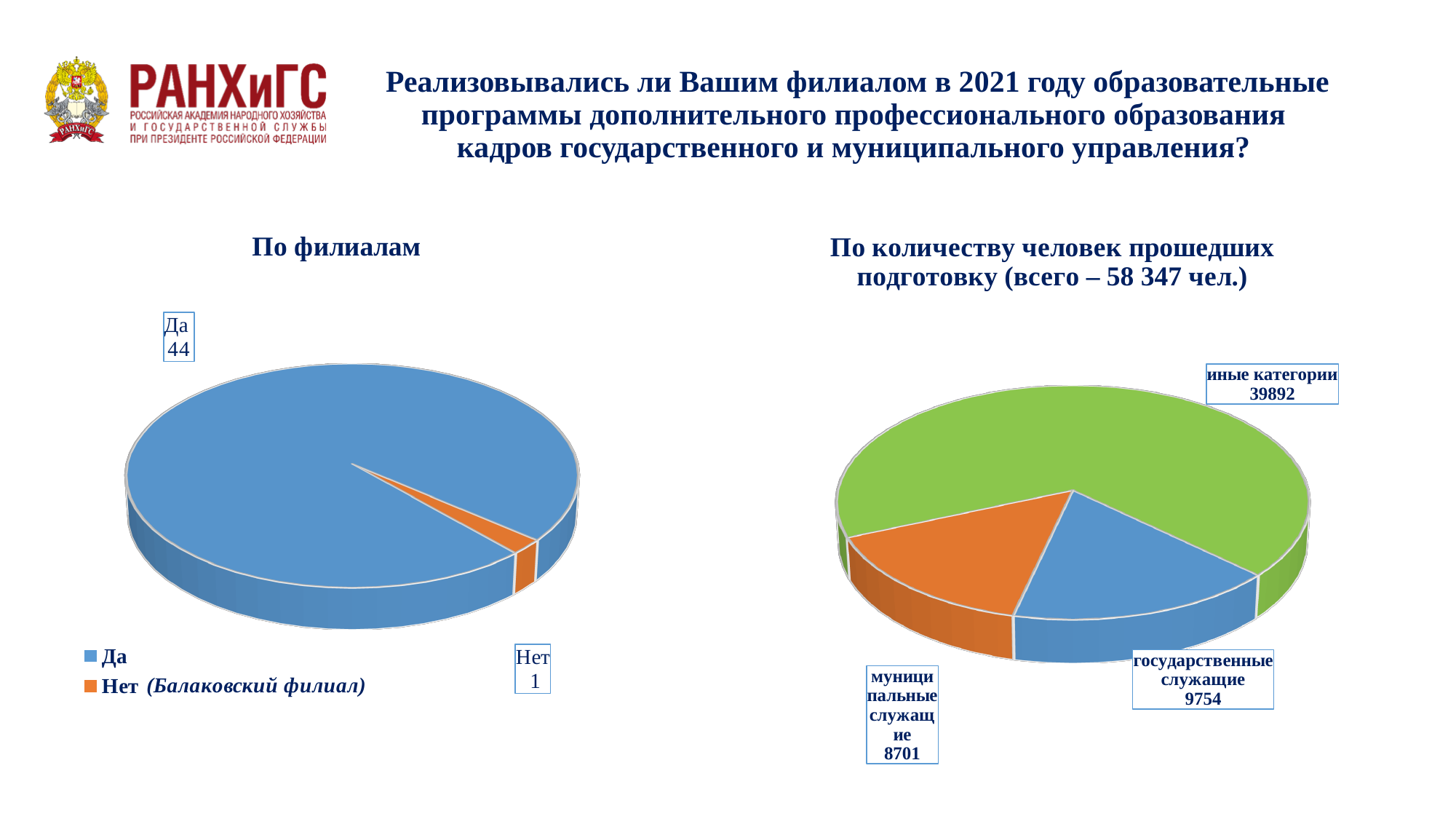
In the right chart on the number of people trained, which category has the largest value? иные категории In the chart titled 'По филиалам', which branch is named as having answered 'Нет'? Балаковский филиал In the right chart on the number of people trained, what is the value for 'муниципальные служащие'? 8701 In the chart titled 'По филиалам', what is the difference between the 'Да' and 'Нет' values? 43 What type of chart is the left chart titled 'По филиалам'? Pie chart In the right chart on the number of people trained, what is the value for 'государственные служащие'? 9754 How many categories does the right chart on the number of people trained show? 3 In the right chart on the number of people trained, what is the value for 'иные категории'? 39892 In the right chart on the number of people trained, what is the difference between 'государственные служащие' and 'муниципальные служащие'? 1053 In the right chart on the number of people trained, which category has the smallest value? муниципальные служащие In the chart titled 'По филиалам', how many branches answered 'Да'? 44 In the chart titled 'По филиалам', how many branches answered 'Нет'? 1